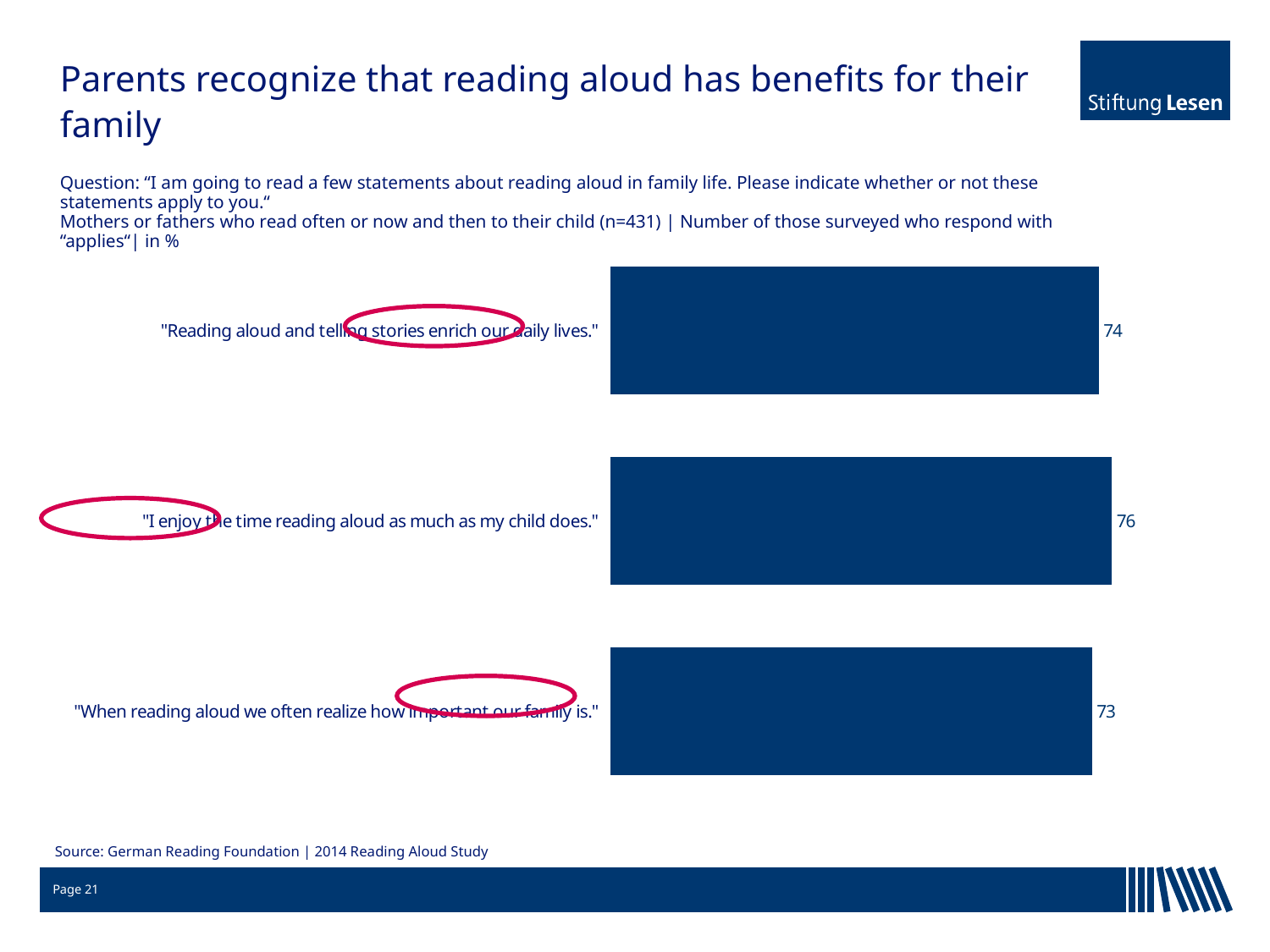
Which statement has the highest share of respondents answering "applies"? "I enjoy the time reading aloud as much as my child does." Which statement has the lowest share of respondents answering "applies"? "When reading aloud we often realize how important our family is." What type of chart is shown on the slide? Bar chart Which has a higher value: "Reading aloud and telling stories enrich our daily lives" or "When reading aloud we often realize how important our family is"? "Reading aloud and telling stories enrich our daily lives." What value is shown for the statement "When reading aloud we often realize how important our family is"? 73 What is the difference between the values for "I enjoy the time reading aloud as much as my child does" and "When reading aloud we often realize how important our family is"? 3 What value is shown for the statement "I enjoy the time reading aloud as much as my child does"? 76 What is the sample size (n) of the surveyed parents stated on the slide? 431 How many statements are shown in the chart? 3 What is the difference between the values for "I enjoy the time reading aloud as much as my child does" and "Reading aloud and telling stories enrich our daily lives"? 2 What percentage of parents said "Reading aloud and telling stories enrich our daily lives" applies to them? 74 What is the source given for the chart data? German Reading Foundation | 2014 Reading Aloud Study